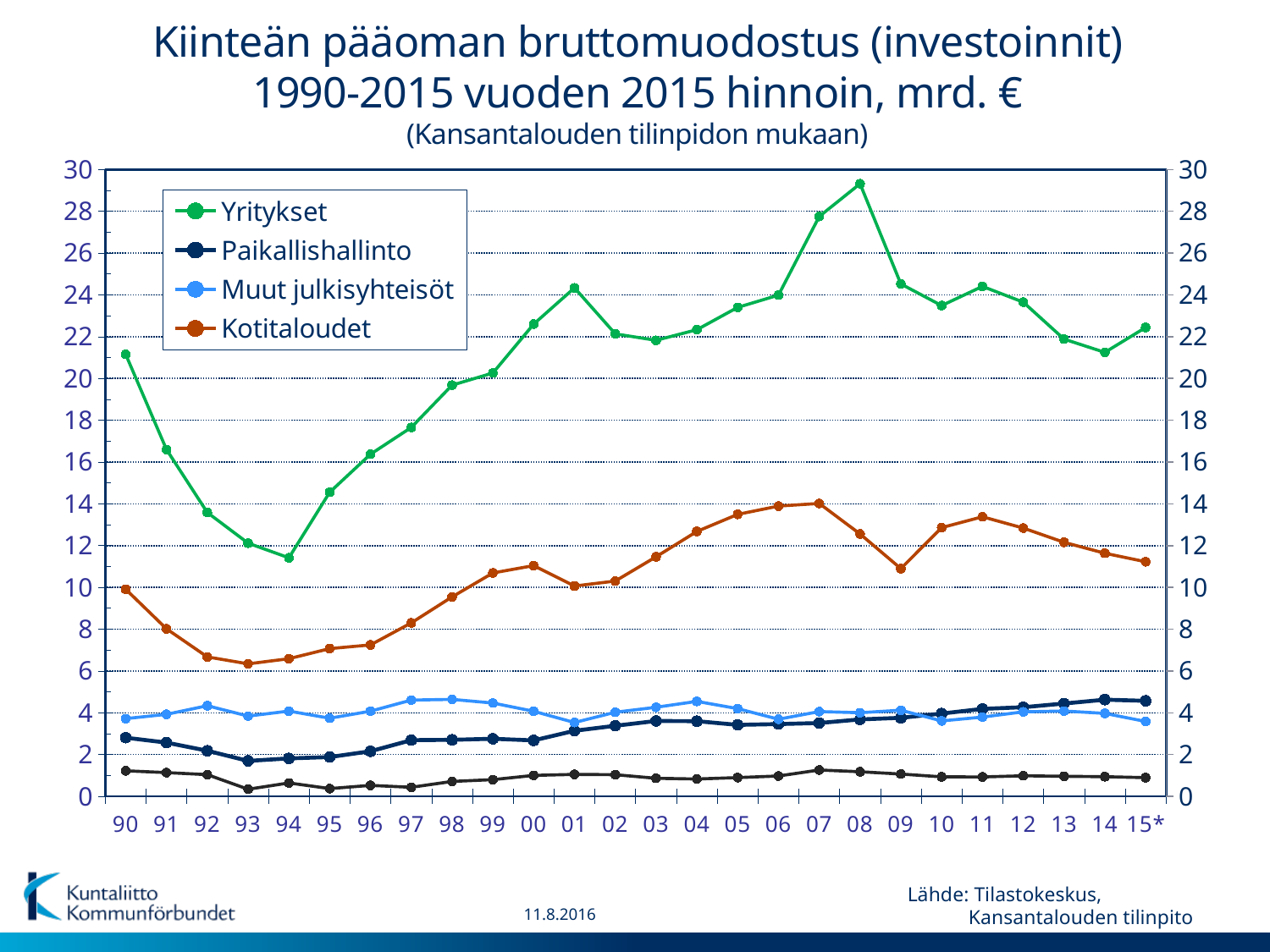
Is the value for Yritykset in 08 greater or less than 28? greater What kind of chart is shown on the slide? Line chart Is the value for Muut julkisyhteisöt in 93 greater or less than 1? greater Does the Yritykset series rise or fall from 90 to 94? Fall In which year does the Yritykset series reach its highest value? 08 Which is larger in 00: Kotitaloudet or Paikallishallinto? Kotitaloudet Which series is plotted in green? Yritykset How many series does the legend list? 4 Is the value for Kotitaloudet in 93 greater or less than 8? less How many years (points) are plotted along the x axis? 26 In which year does the Yritykset series reach its lowest value? 94